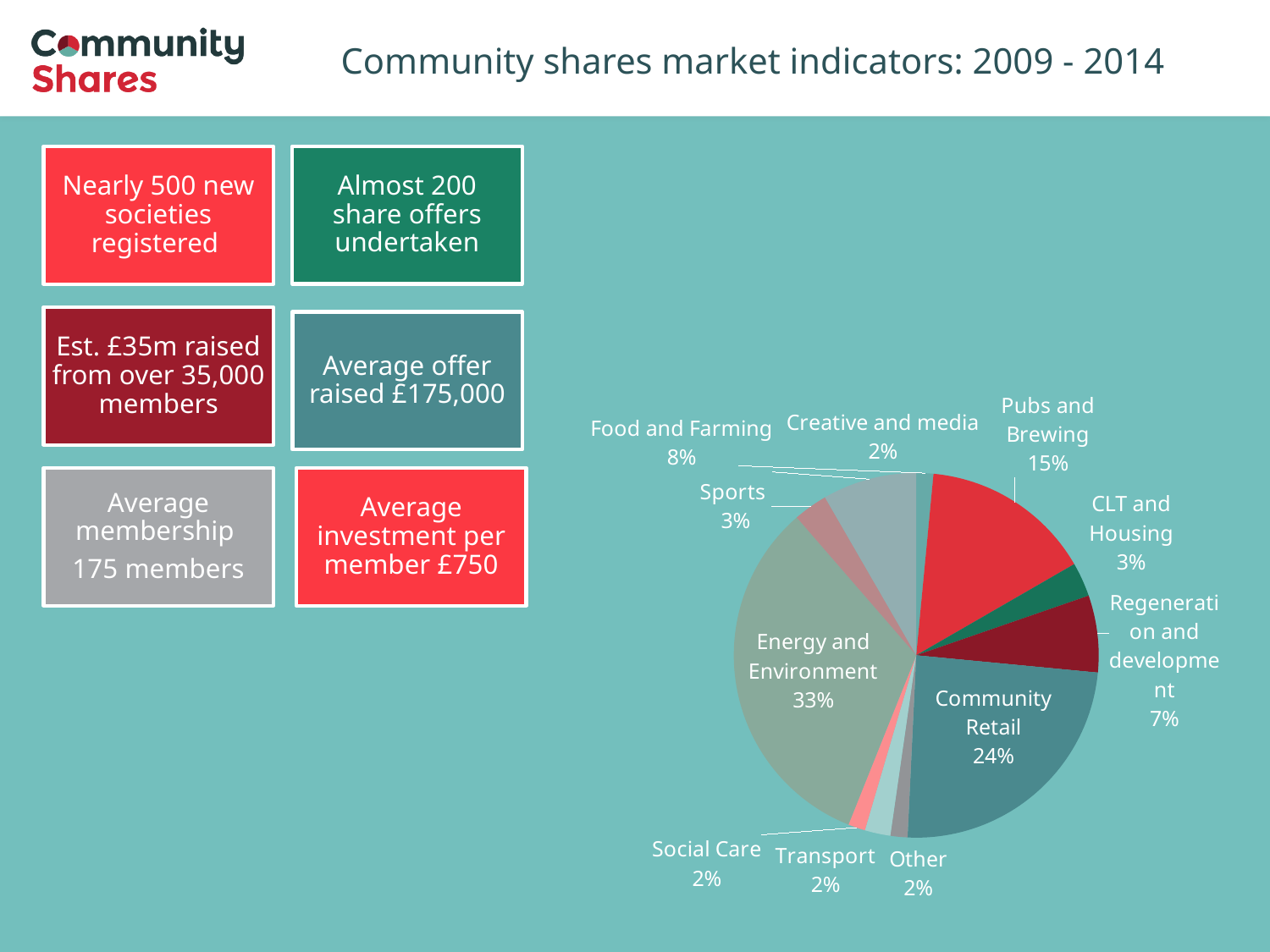
What is the value for Food and Farming? 8% What is the value for Sports? 3% What is the value for Regeneration and development? 7% What is the difference between Energy and Environment and Community Retail? 9% Which is larger, Pubs and Brewing or Food and Farming? Pubs and Brewing How many categories are shown in the pie chart? 11 What is the value for Pubs and Brewing? 15% What is the difference between Pubs and Brewing and CLT and Housing? 12% What share of the pie does Energy and Environment have? 33% What is the value for Community Retail? 24% Which category has the largest slice of the pie? Energy and Environment What kind of chart is shown on the slide? pie chart